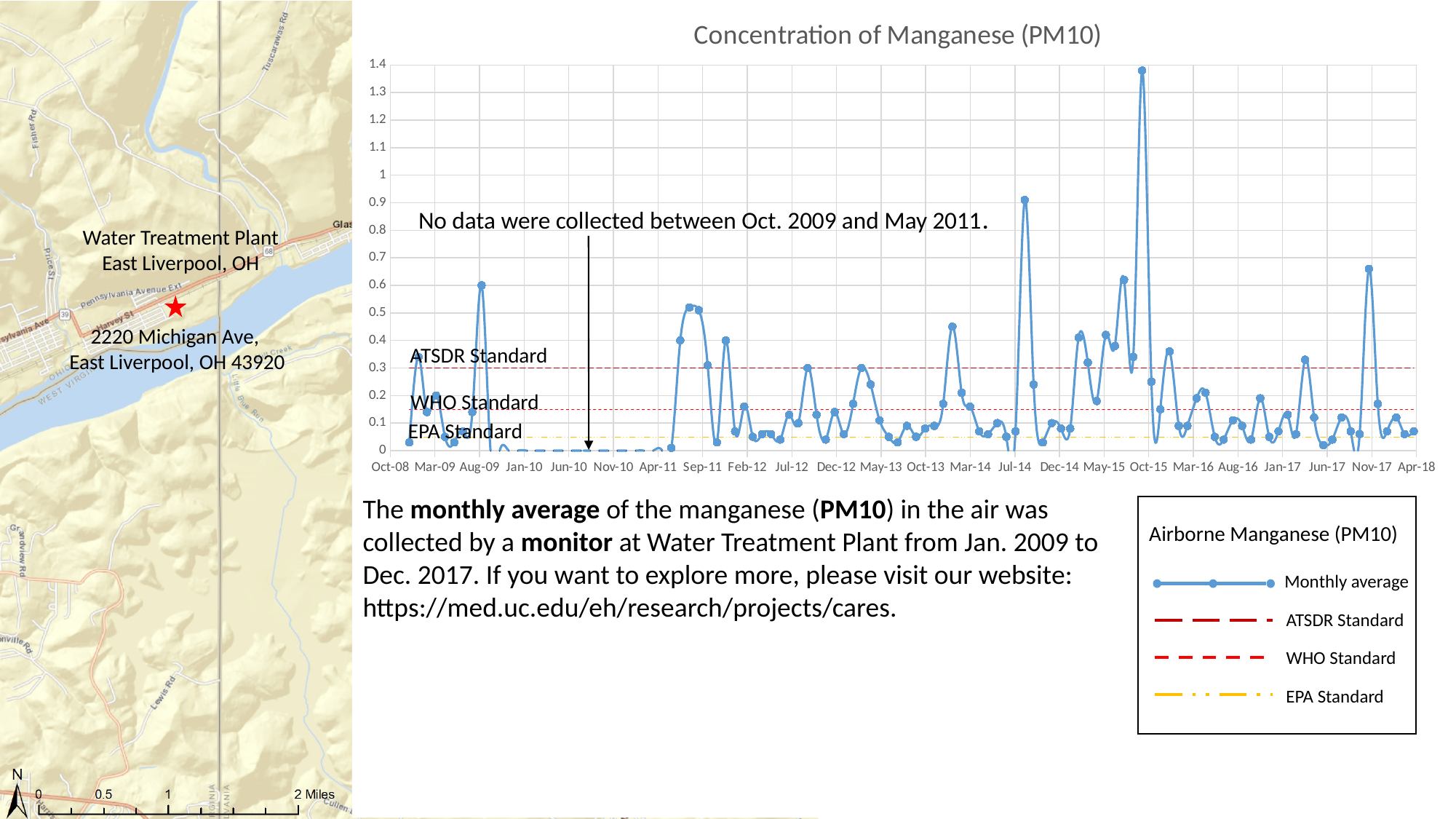
What kind of chart is shown on the slide? line chart Which is higher, the peak monthly average near Jul-14 or the peak at Oct-15? Oct-15 How many entries does the chart's legend list? 4 Is the peak monthly average value near Jul-14 greater or less than 0.8? greater According to the annotation on the chart, between which dates were no data collected? Oct. 2009 and May 2011 What is the title of the chart? Concentration of Manganese (PM10) Which month shows the highest monthly average manganese concentration? Oct-15 Is the peak monthly average value at Oct-15 greater or less than 1.3? greater At what concentration is the ATSDR Standard line drawn? 0.3